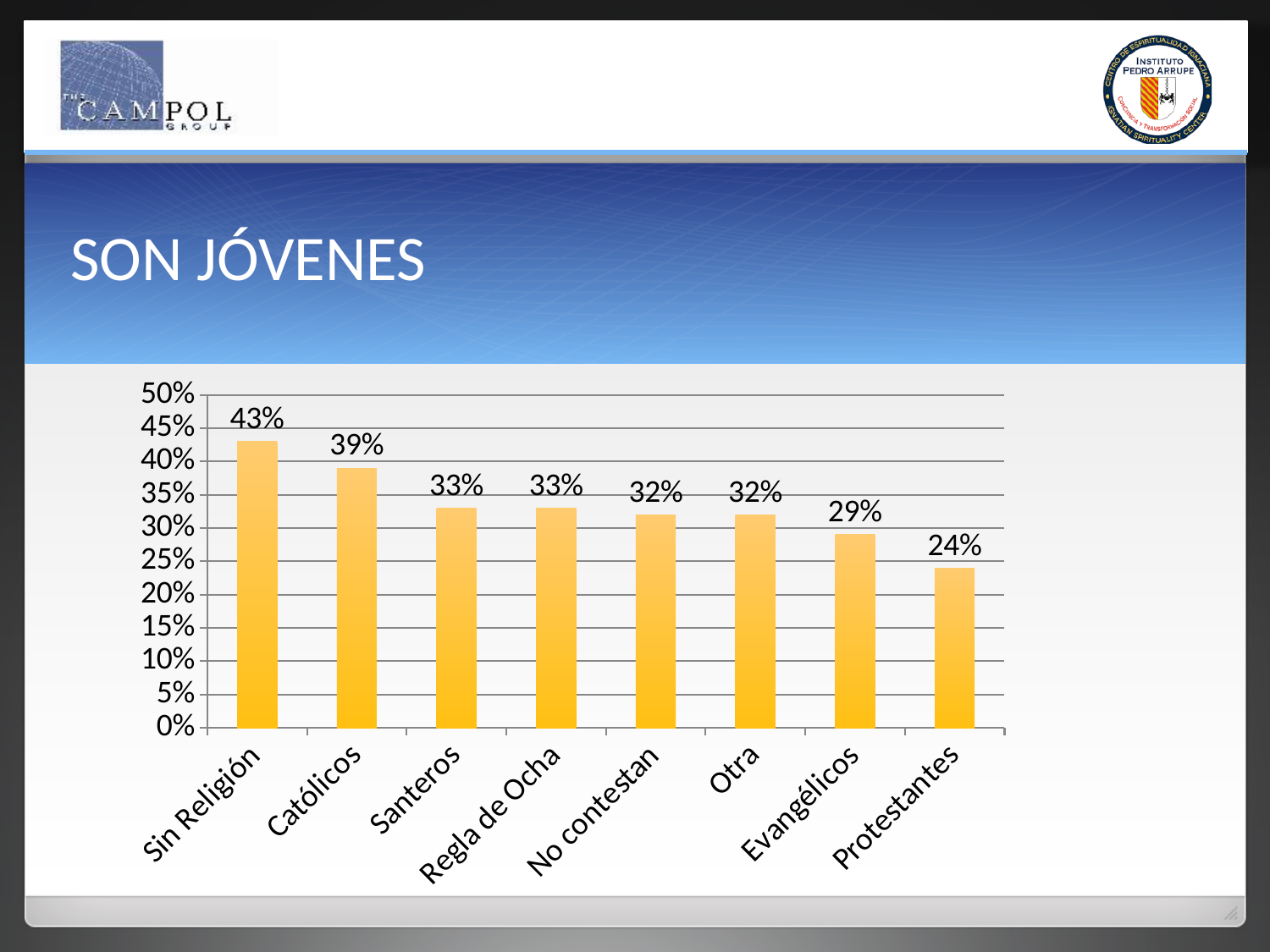
What is the difference between the values for Sin Religión and Protestantes? 19% What is the difference between the values for Católicos and Evangélicos? 10% What is the value for Evangélicos? 29% Which is larger, the value for Santeros or the value for Evangélicos? Santeros What kind of chart is shown on the slide? Bar chart Is the value for Otra greater or less than 30%? greater How many categories are shown on the x axis? 8 What is the value for Sin Religión? 43% Which category has the highest value? Sin Religión Which category has the lowest value? Protestantes What is the value for Protestantes? 24% What is the value for Católicos? 39%